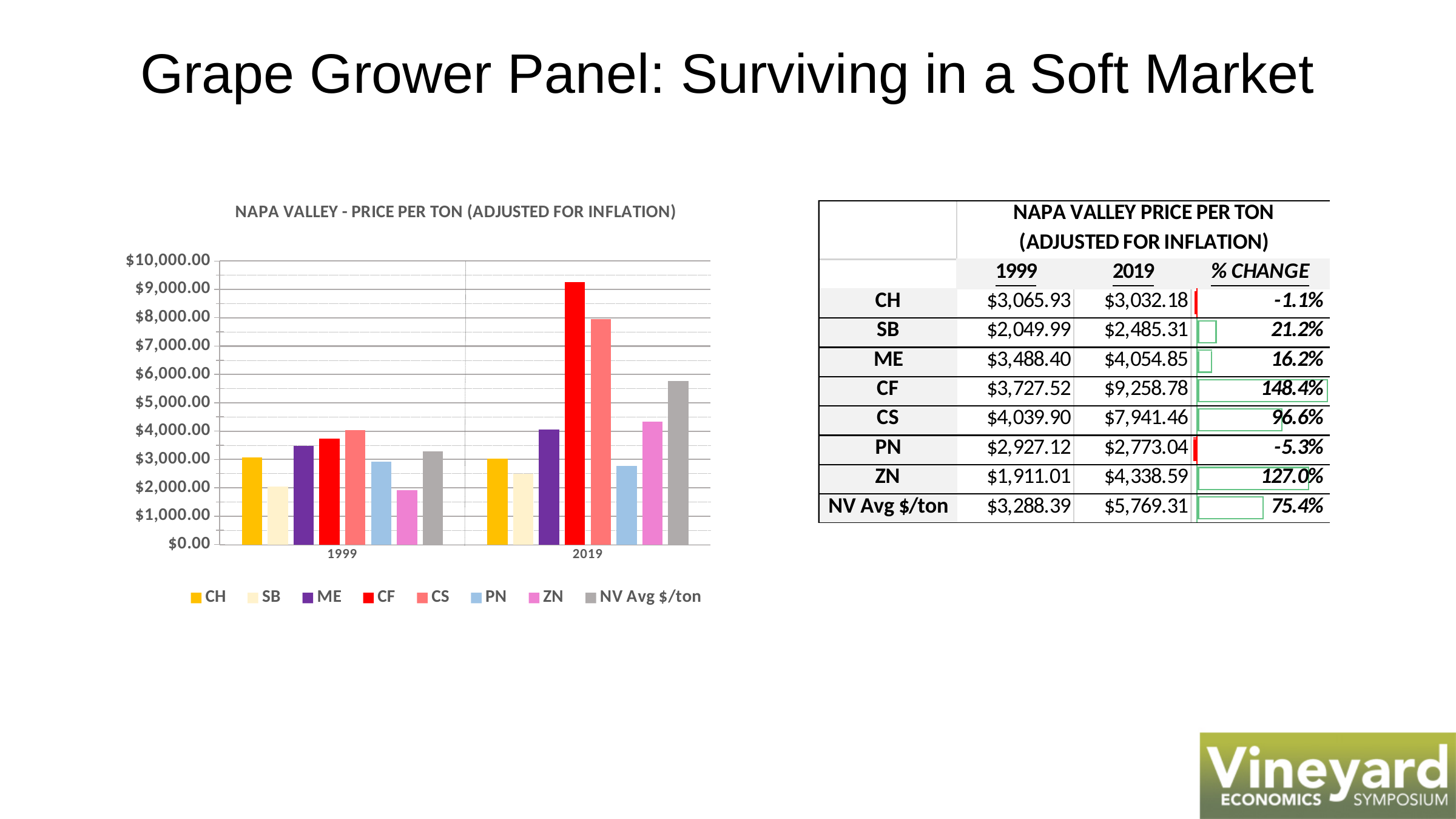
Does the value for CF rise or fall from 1999 to 2019? rise Which series has the lowest bar in 2019? SB How many year categories are shown on the x axis of the chart? 2 Which series has the lowest bar in 1999? ZN In 2019, which is larger, the bar for CS or the bar for ME? CS Which series has the highest bar in 2019? CF What kind of chart is shown on the slide? bar chart How many series does the chart legend list? 8 What is the title of the chart? NAPA VALLEY - PRICE PER TON (ADJUSTED FOR INFLATION) Is the value for CF in 2019 greater or less than $9,000.00? greater Which series has the highest bar in 1999? CS Is the value for NV Avg $/ton in 1999 greater or less than $4,000.00? less